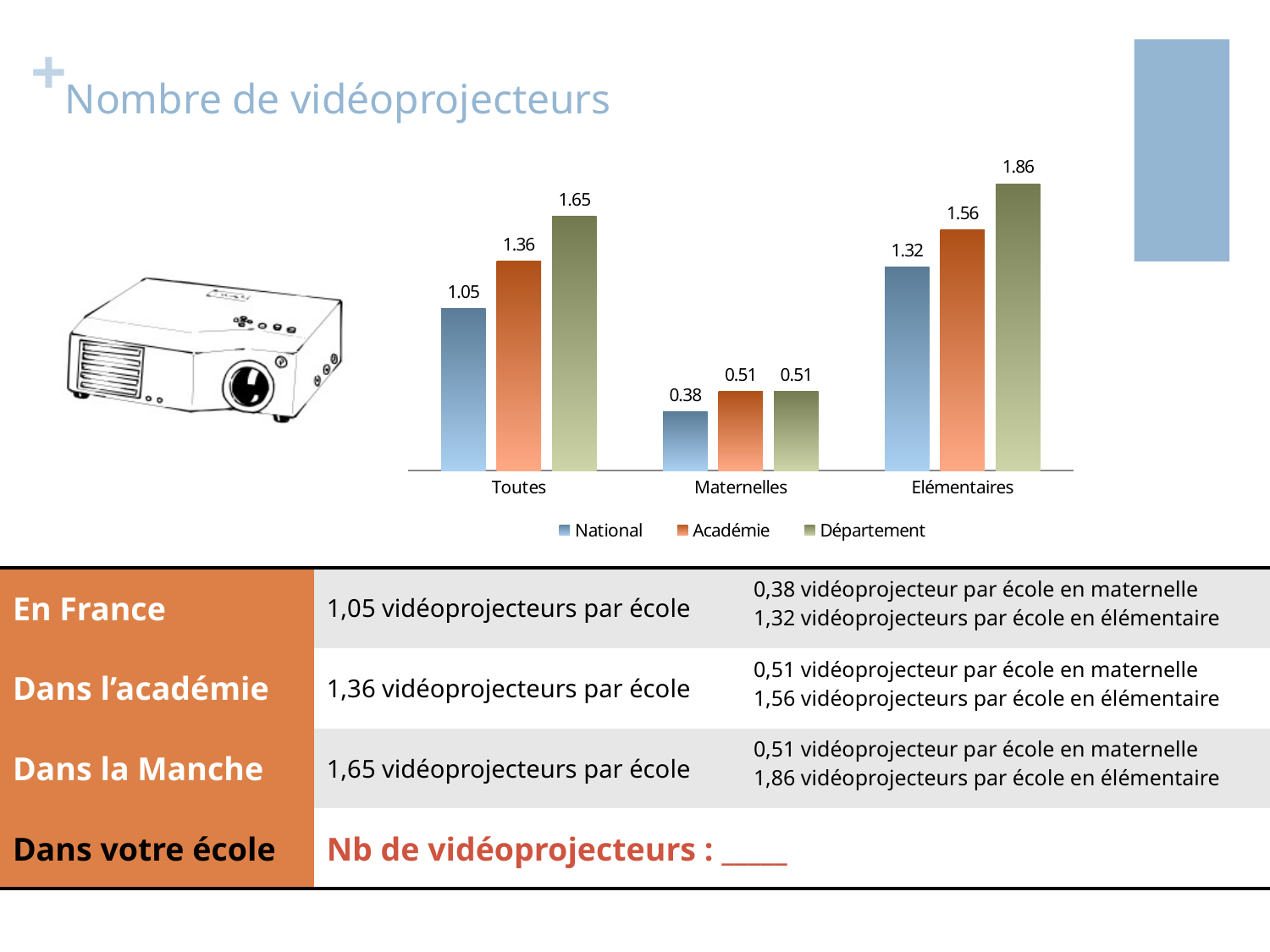
Which category has the highest Département value? Elémentaires Which category has the lowest National value? Maternelles What is the difference between the Département and National values for Toutes? 0.60 What is the National value for Toutes? 1.05 What is the Département value for Elémentaires? 1.86 How many series does the legend list? 3 What is the difference between the Académie and National values for Elémentaires? 0.24 Which is larger for Elémentaires: the National value or the Académie value? Académie How many categories are shown on the x axis? 3 What is the Académie value for Maternelles? 0.51 Which series is shown in orange in the legend? Académie What kind of chart is shown on the slide? Bar chart